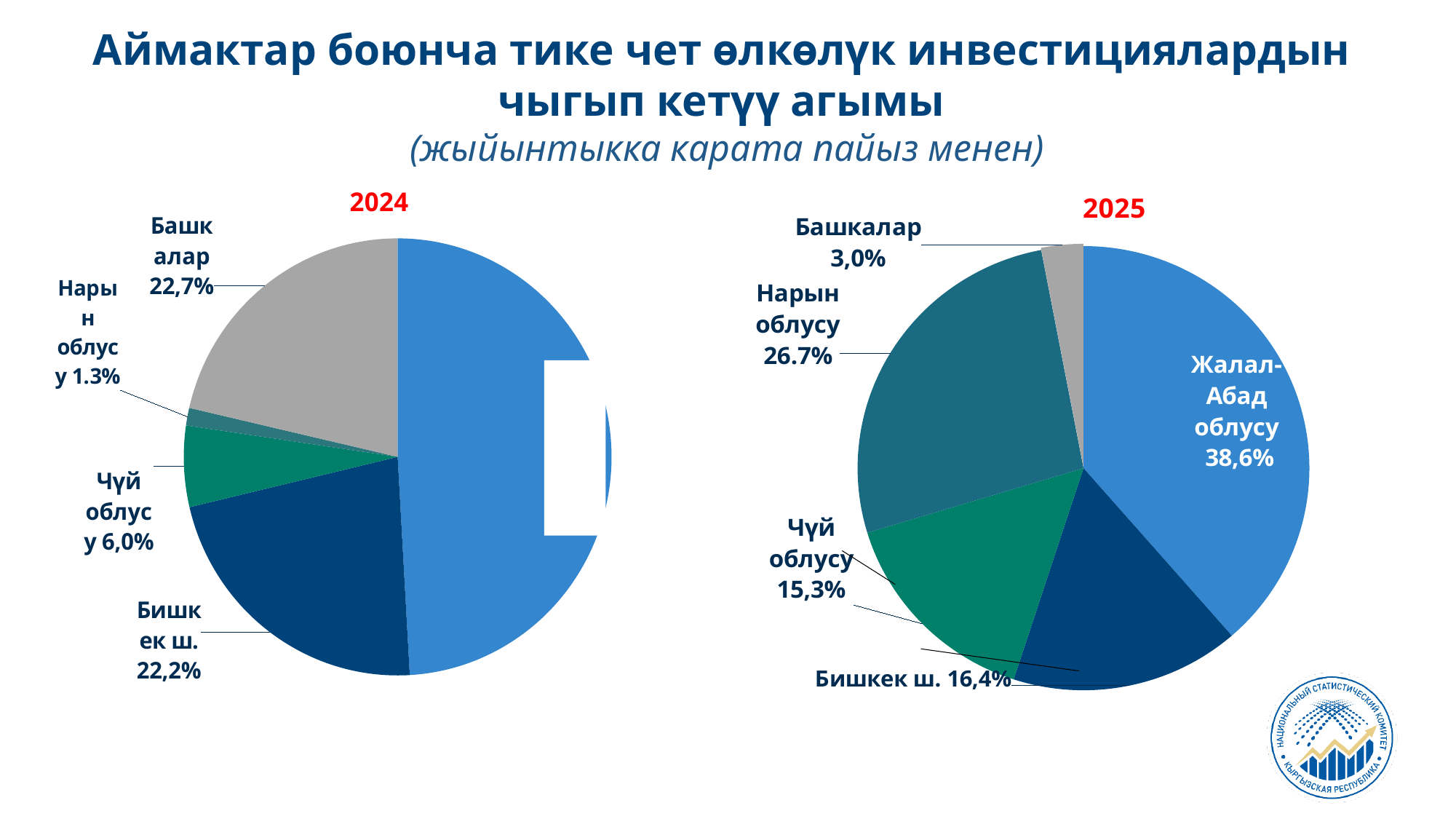
How many slices does the 2025 pie chart have? 5 In the 2024 pie chart, what share does Чүй облусу have? 6,0% In the 2025 pie chart, which labelled region has the largest share? Жалал-Абад облусу In the 2025 pie chart, what is the value for Нарын облусу? 26.7% In the 2024 pie chart, what is the value for Бишкек ш.? 22,2% In the 2024 pie chart, which labelled category has the smallest share? Нарын облусу In the 2025 pie chart, what share does Жалал-Абад облусу have? 38,6% What type of chart is used for the 2024 data? Pie chart In the 2025 pie chart, what is the difference in percentage points between Жалал-Абад облусу and Нарын облусу? 11,9 In the 2025 pie chart, what is the difference in percentage points between Бишкек ш. and Чүй облусу? 1,1 In the 2024 pie chart, which is larger: Башкалар or Бишкек ш.? Башкалар In the 2025 pie chart, which category has the smallest share? Башкалар